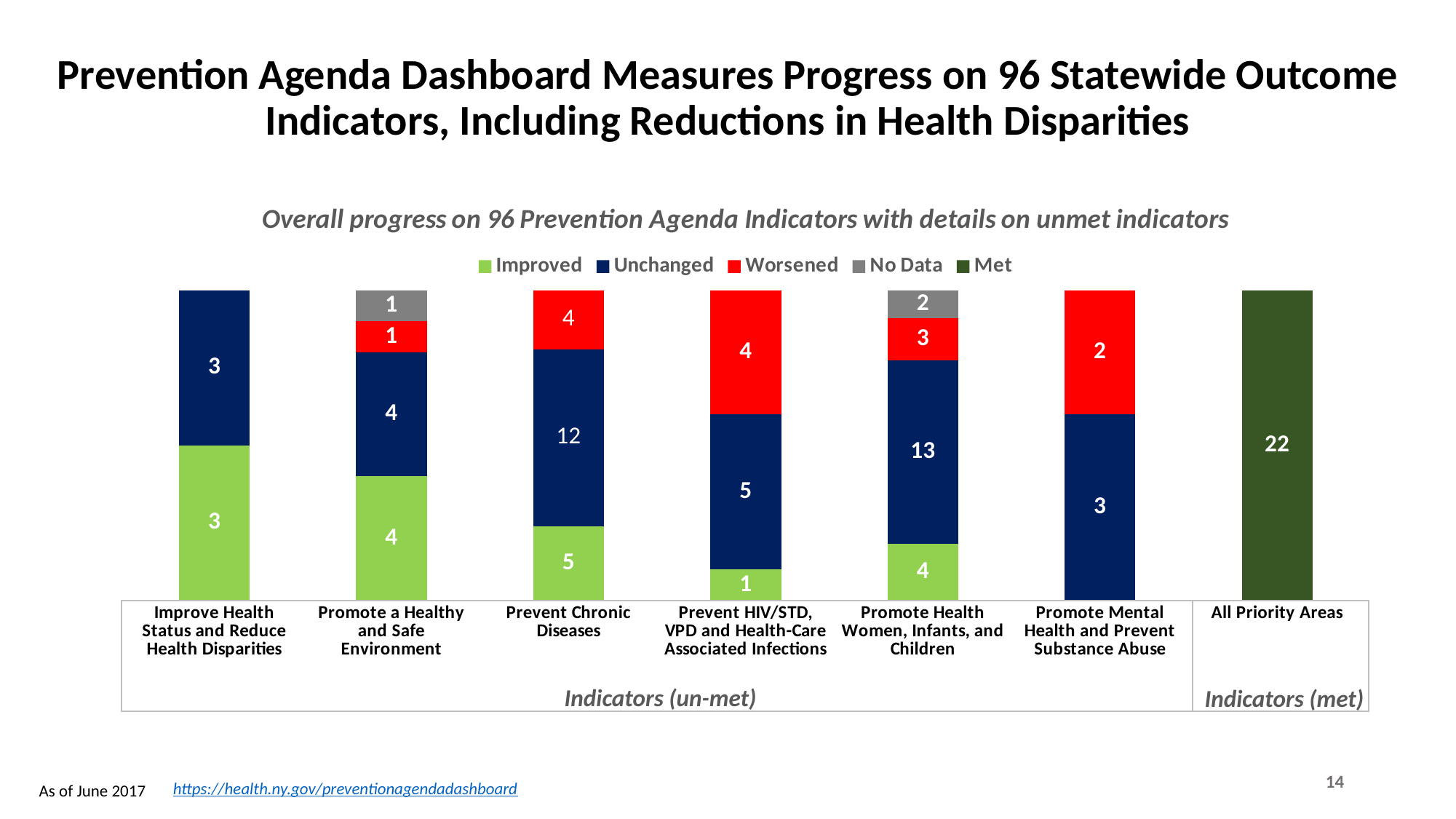
What kind of chart is shown on the slide? Stacked bar chart What is the Unchanged value for Prevent Chronic Diseases? 12 Which is larger, the Worsened value for Promote Mental Health and Prevent Substance Abuse or the Worsened value for Prevent Chronic Diseases? Prevent Chronic Diseases What is the No Data value for Promote a Healthy and Safe Environment? 1 What is the total of the stacked bar for Prevent Chronic Diseases? 21 What is the Worsened value for Prevent HIV/STD, VPD and Health-Care Associated Infections? 4 Which category has the highest Unchanged value? Promote Health Women, Infants, and Children What is the Met value for All Priority Areas? 22 What is the difference between the Unchanged values for Promote Health Women, Infants, and Children and Prevent Chronic Diseases? 1 How many series does the legend list? 5 What is the Improved value for Promote Health Women, Infants, and Children? 4 Which category has the lowest Improved value among those with an Improved segment? Prevent HIV/STD, VPD and Health-Care Associated Infections